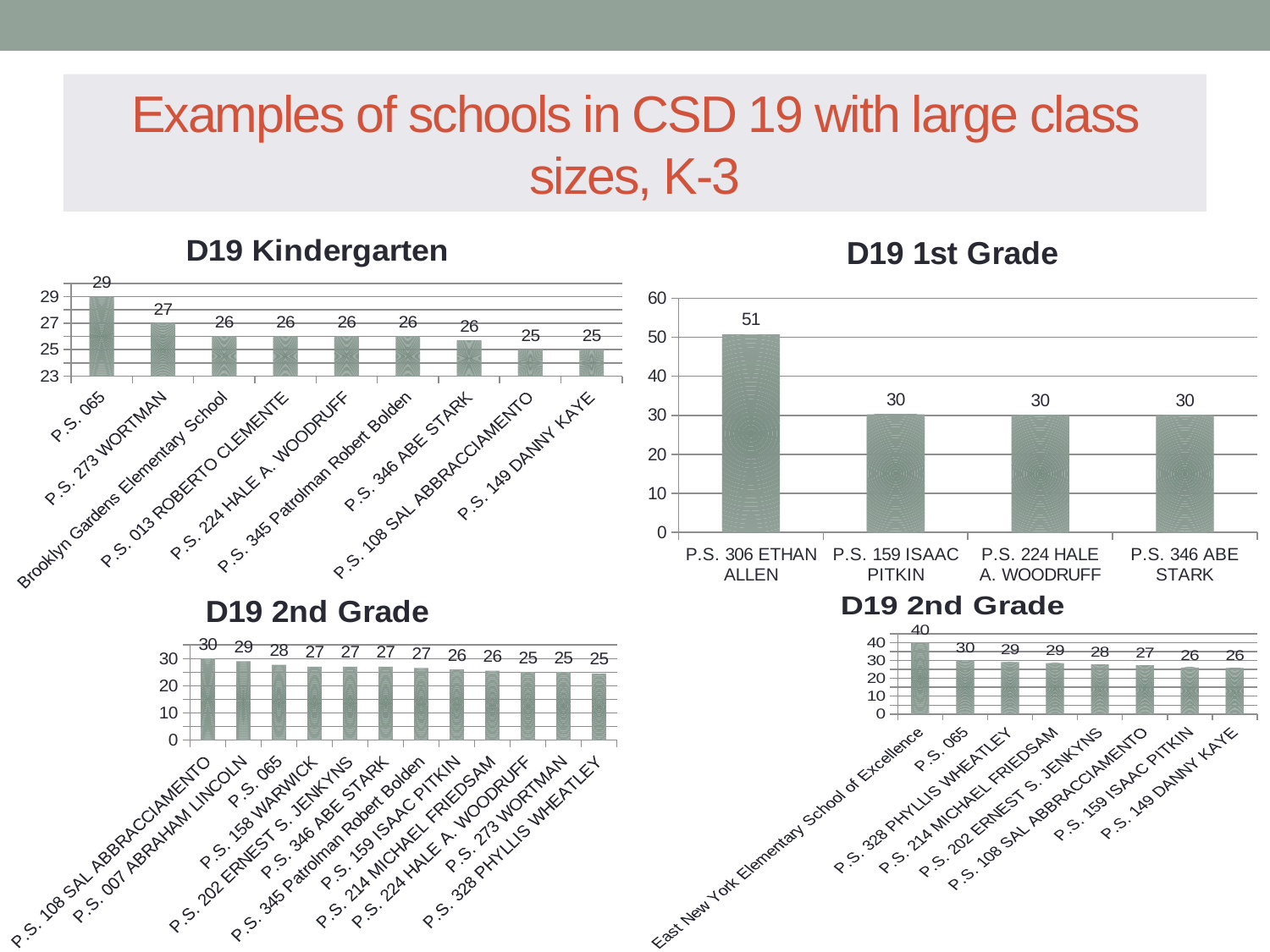
In the D19 2nd Grade chart at the bottom left, how many schools are shown? 12 What kind of chart is the D19 1st Grade chart? Bar chart In the D19 1st Grade chart, which school has the highest value? P.S. 306 ETHAN ALLEN In the D19 Kindergarten chart, what is the value for P.S. 065? 29 In the D19 2nd Grade chart at the bottom right, what is the value for East New York Elementary School of Excellence? 40 In the D19 1st Grade chart, how many schools are shown? 4 In the D19 2nd Grade chart at the bottom right, which is larger, the value for P.S. 065 or the value for P.S. 149 DANNY KAYE? P.S. 065 In the D19 1st Grade chart, what is the value for P.S. 159 ISAAC PITKIN? 30 In the D19 2nd Grade chart at the bottom left, what is the value for P.S. 007 ABRAHAM LINCOLN? 29 In the D19 Kindergarten chart, what is the value for P.S. 273 WORTMAN? 27 In the D19 1st Grade chart, what is the difference between P.S. 306 ETHAN ALLEN and P.S. 346 ABE STARK? 21 In the D19 Kindergarten chart, how many schools are shown? 9